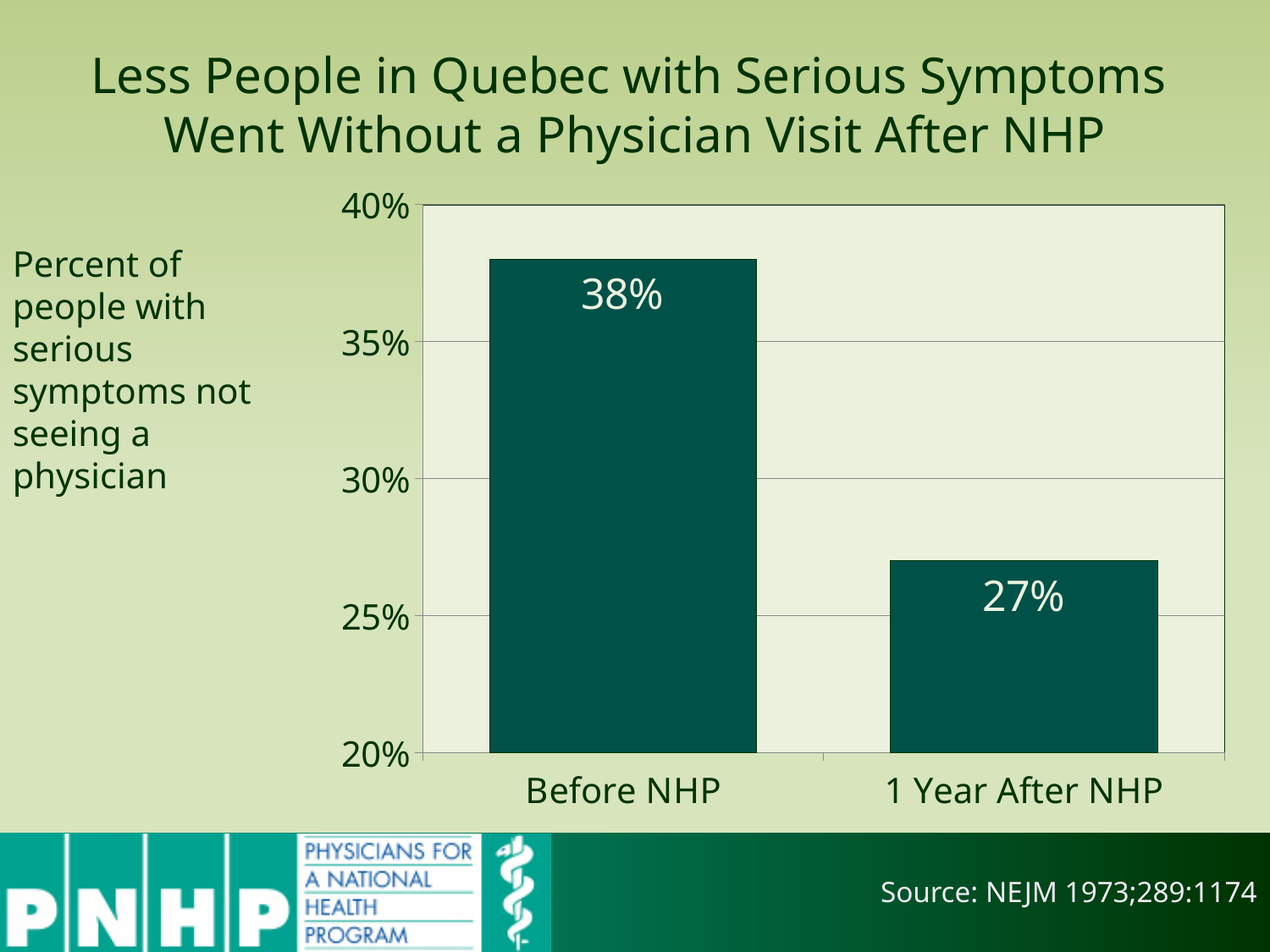
Which category has the highest value? Before NHP What is the source cited at the bottom of the slide? NEJM 1973;289:1174 Which is larger, the value for Before NHP or the value for 1 Year After NHP? Before NHP What is the value for 1 Year After NHP? 27% What is the value for Before NHP? 38% How many categories are shown on the x axis? 2 What kind of chart is shown on the slide? bar chart Which category has the lowest value? 1 Year After NHP Is the value for Before NHP greater or less than 35%? greater Do the values rise or fall from Before NHP to 1 Year After NHP? fall What is the difference between the Before NHP value and the 1 Year After NHP value? 11% Is the value for 1 Year After NHP greater or less than 30%? less